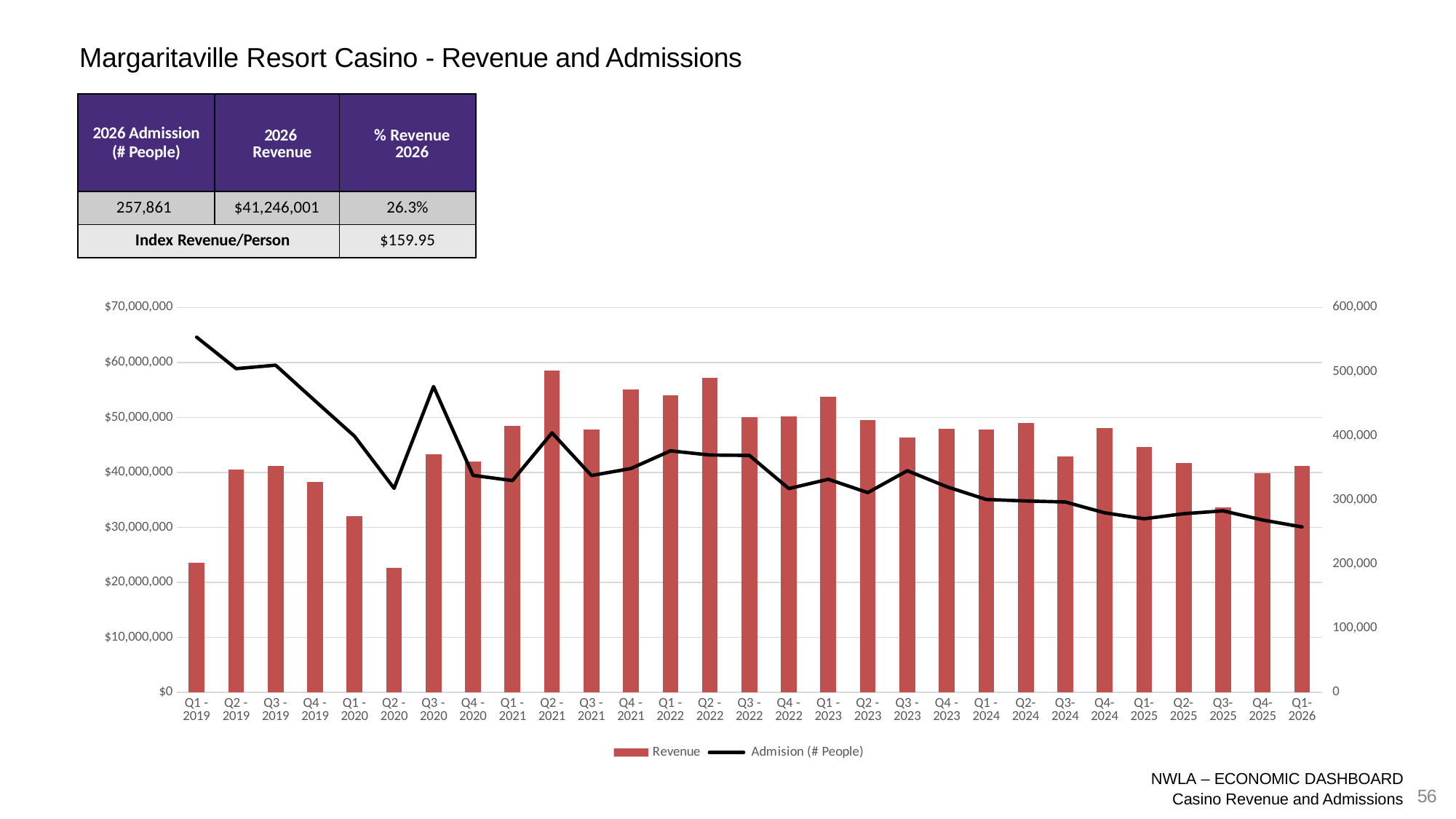
Is the Admission (# People) value for Q1- 2026 greater or less than 300,000? less What are the two entries in the chart legend? Revenue and Admision (# People) Is the Revenue value for Q2 - 2021 greater or less than $50,000,000? greater Is the Admission (# People) value for Q1 - 2019 greater or less than 500,000? greater Does the Admission (# People) line generally rise or fall from Q1 - 2019 to Q1- 2026? fall How many quarters are plotted along the x axis of the chart? 29 Which quarter has the larger Revenue value, Q2 - 2021 or Q1 - 2020? Q2 - 2021 Which quarter has the highest Admission (# People) value on the chart? Q1 - 2019 How many series does the chart legend list? 2 Which quarter has the lowest Admission (# People) value on the chart? Q1- 2026 What kind of chart is used to show Revenue on the slide? bar chart